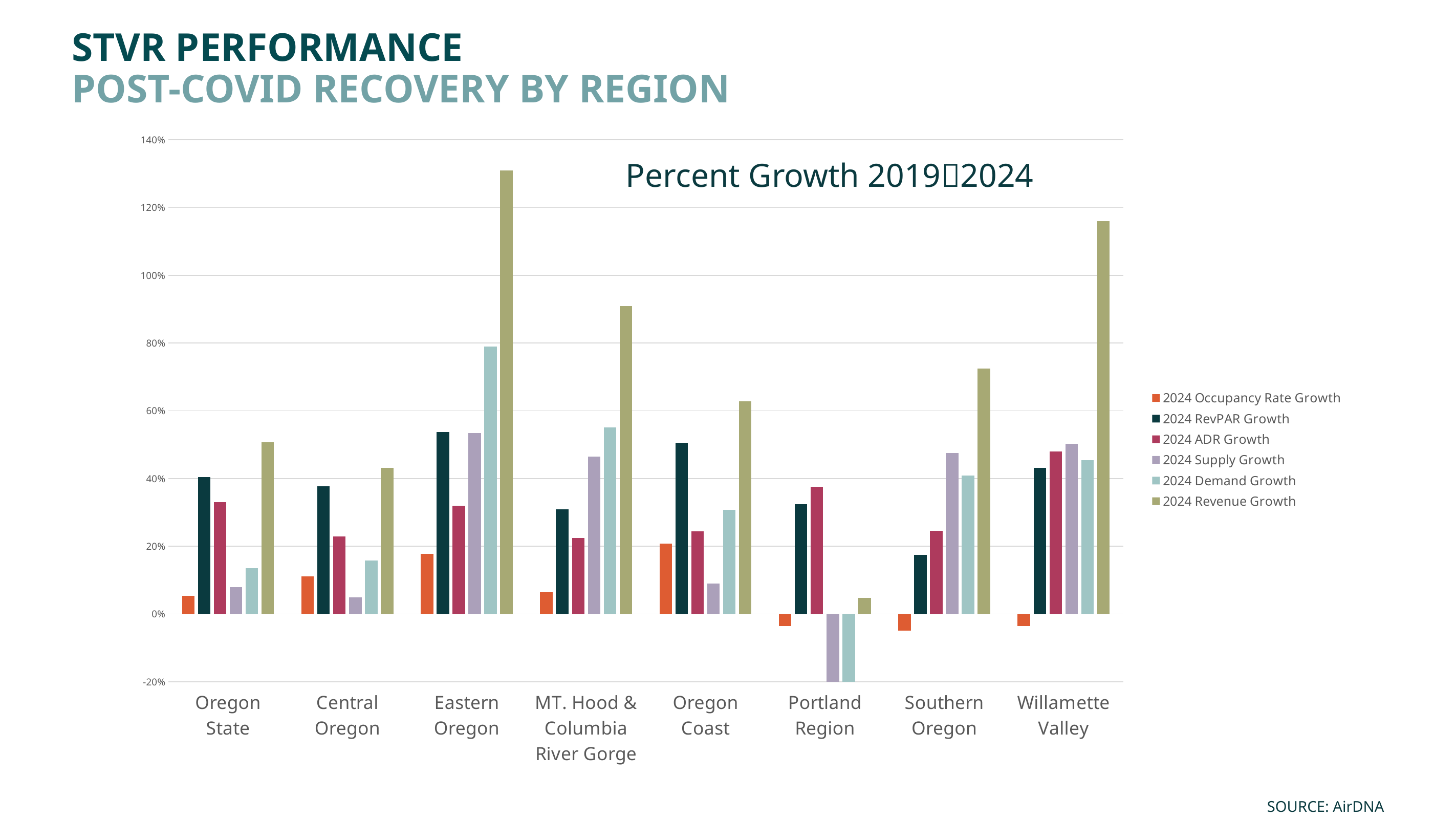
How many series does the legend list? 6 Is the 2024 Demand Growth for Portland Region greater or less than 0%? less What kind of chart is shown on the slide? bar chart Is the 2024 Revenue Growth for Willamette Valley greater or less than 100%? greater Which is larger, the 2024 RevPAR Growth for Oregon Coast or for Southern Oregon? Oregon Coast Which is larger for MT. Hood & Columbia River Gorge, 2024 Demand Growth or 2024 Supply Growth? 2024 Demand Growth Which region has the highest 2024 Revenue Growth? Eastern Oregon Which region has the highest 2024 Demand Growth? Eastern Oregon How many regions are shown along the x axis? 8 Which region has the lowest 2024 Revenue Growth? Portland Region Is the 2024 Revenue Growth for Eastern Oregon greater or less than 120%? greater Which series is shown in orange in the legend? 2024 Occupancy Rate Growth